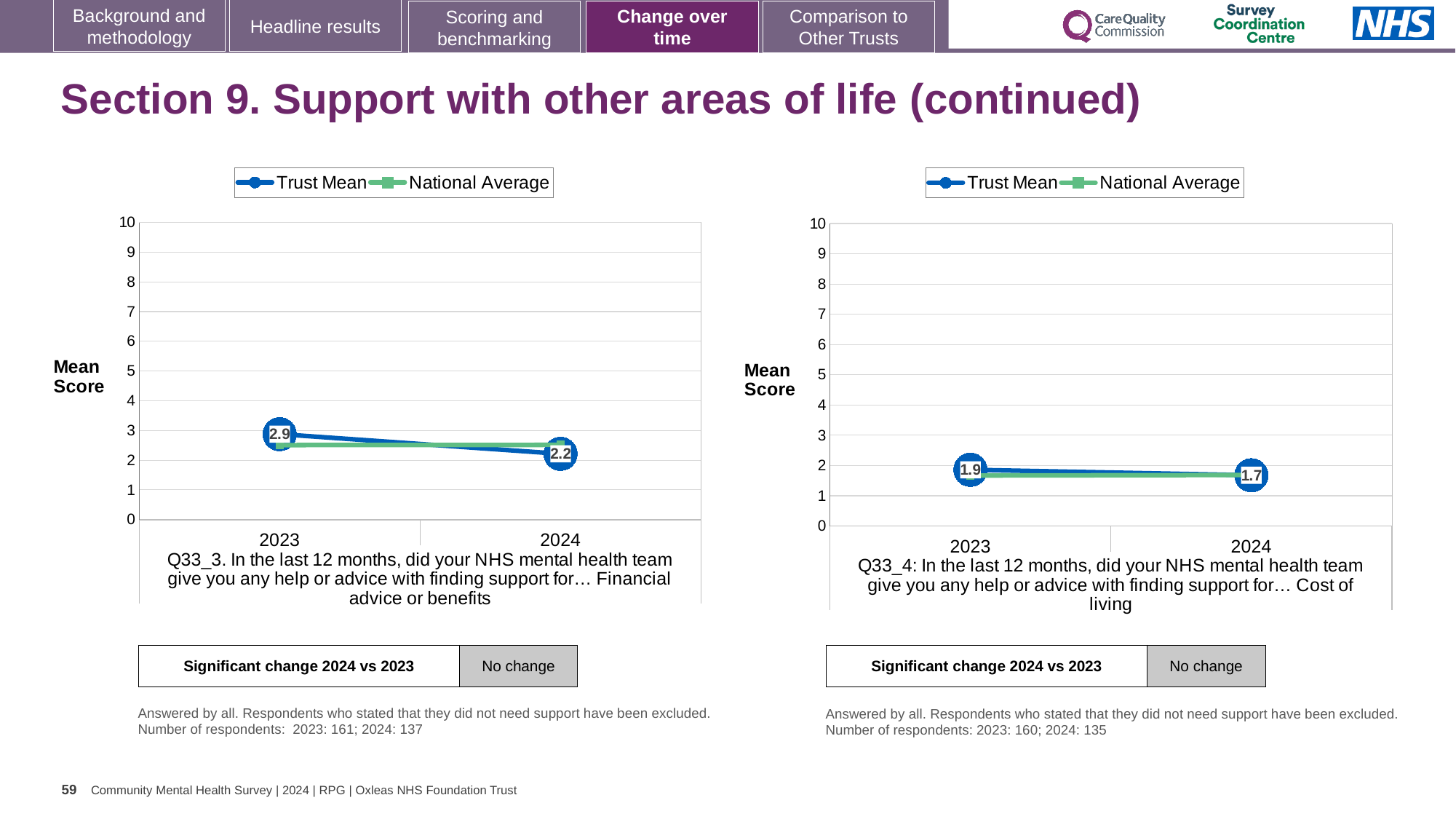
In the right chart (Q33_4, Cost of living), what is the Trust Mean score for 2023? 1.9 In the right chart (Q33_4, Cost of living), what is the Trust Mean score for 2024? 1.7 In the left chart (Q33_3), by how much did the Trust Mean score fall from 2023 to 2024? 0.7 In the right chart (Q33_4), what is the difference between the Trust Mean scores for 2023 and 2024? 0.2 In the left chart (Q33_3, Financial advice or benefits), what is the Trust Mean score for 2024? 2.2 In the left chart (Q33_3), is the National Average value for 2023 greater or less than 3? less How many series does the legend of the left chart list? 2 How many years are plotted on the x axis of the right chart (Q33_4)? 2 In the left chart (Q33_3), does the Trust Mean rise or fall from 2023 to 2024? fall In the left chart (Q33_3), which year has the higher Trust Mean score, 2023 or 2024? 2023 What kind of chart is the right chart (Q33_4, Cost of living)? line chart In the left chart (Q33_3, Financial advice or benefits), what is the Trust Mean score for 2023? 2.9